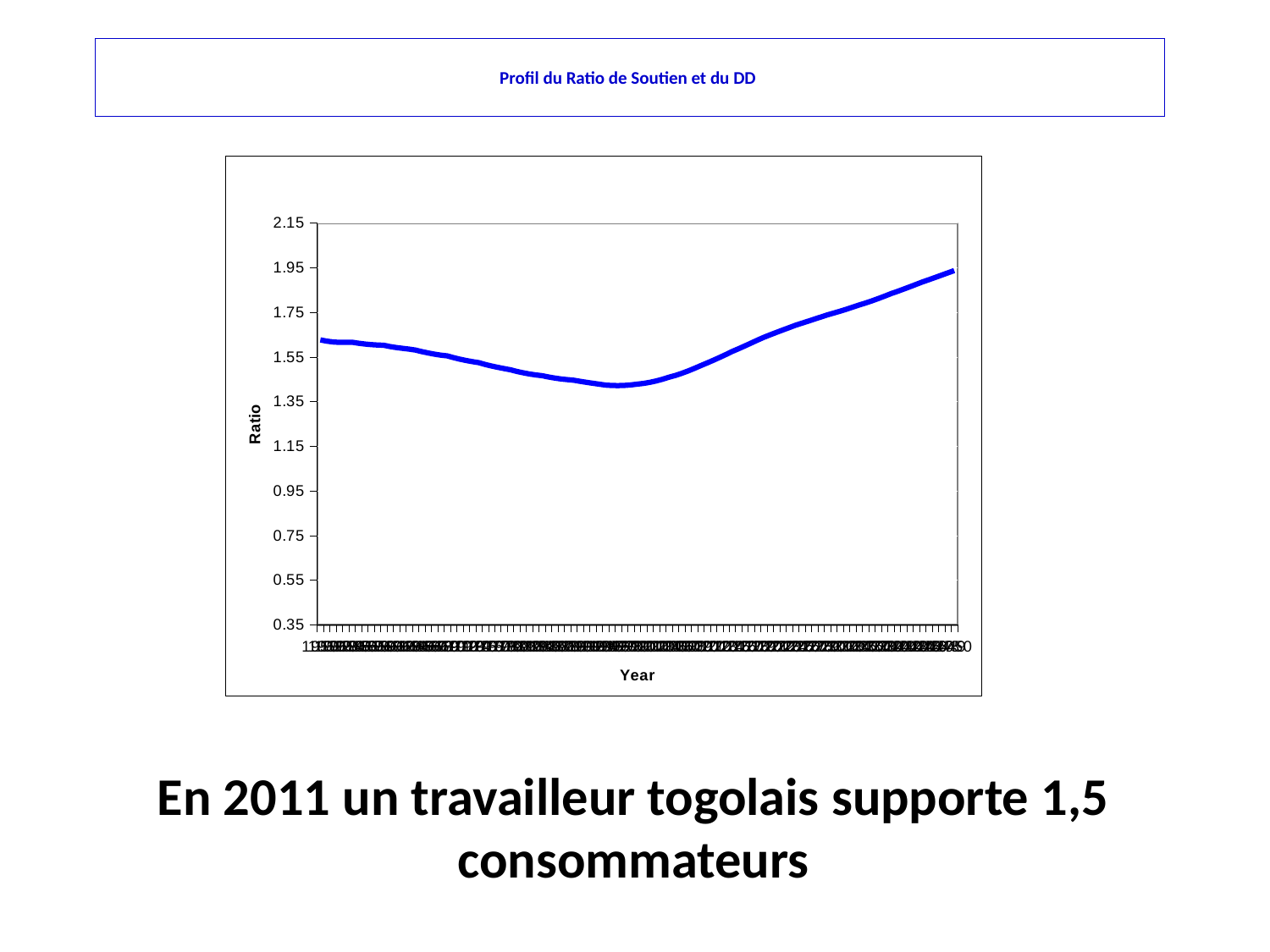
How does the ratio change along the x axis: does it rise throughout, fall throughout, or fall and then rise? fall and then rise What is the title of the horizontal axis of the chart? Year Which is higher, the value at the left end of the line or the value at the right end? the right end Does the line end higher or lower than it starts? higher Is the value at the left end of the line greater or less than 1.55? greater How many lines are plotted on the chart? 1 Is the lowest point of the line greater or less than 1.35? greater Is the value at the right end of the line greater or less than 2.15? less What kind of chart is shown on the slide? line chart What is the title of the vertical axis of the chart? Ratio